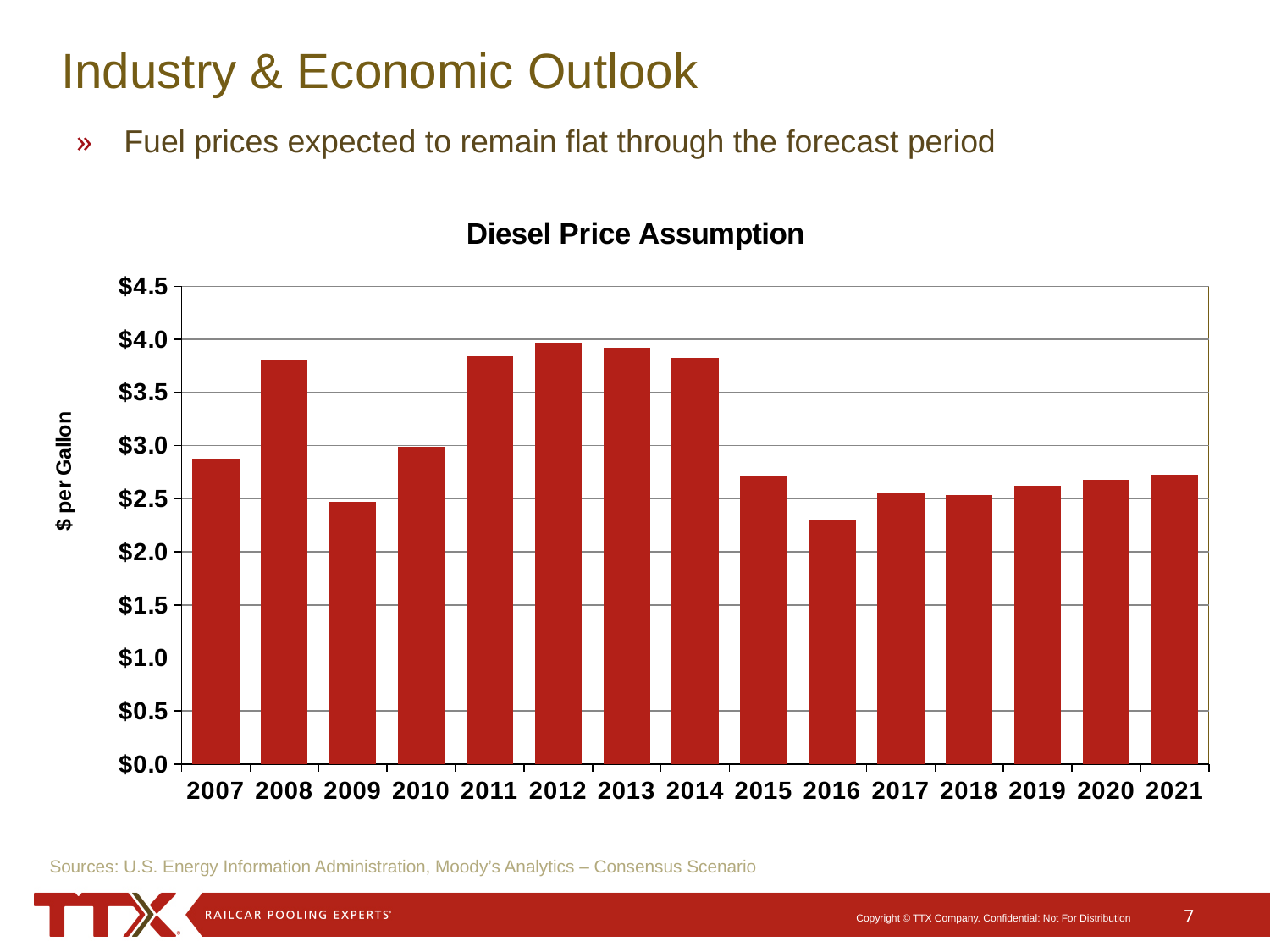
Do diesel prices rise or fall from 2014 to 2016? fall Is the diesel price for 2015 greater or less than $2.5? greater What kind of chart is shown on the slide? bar chart Which year has the lowest diesel price in the chart? 2016 Is the diesel price for 2016 greater or less than $2.5? less Which year has a higher diesel price, 2008 or 2009? 2008 Is the diesel price for 2007 greater or less than $3.0? less What is the label on the vertical axis of the chart? $ per Gallon What is the title of the chart? Diesel Price Assumption Which year has the highest diesel price in the chart? 2012 How many years are shown on the x axis of the chart? 15